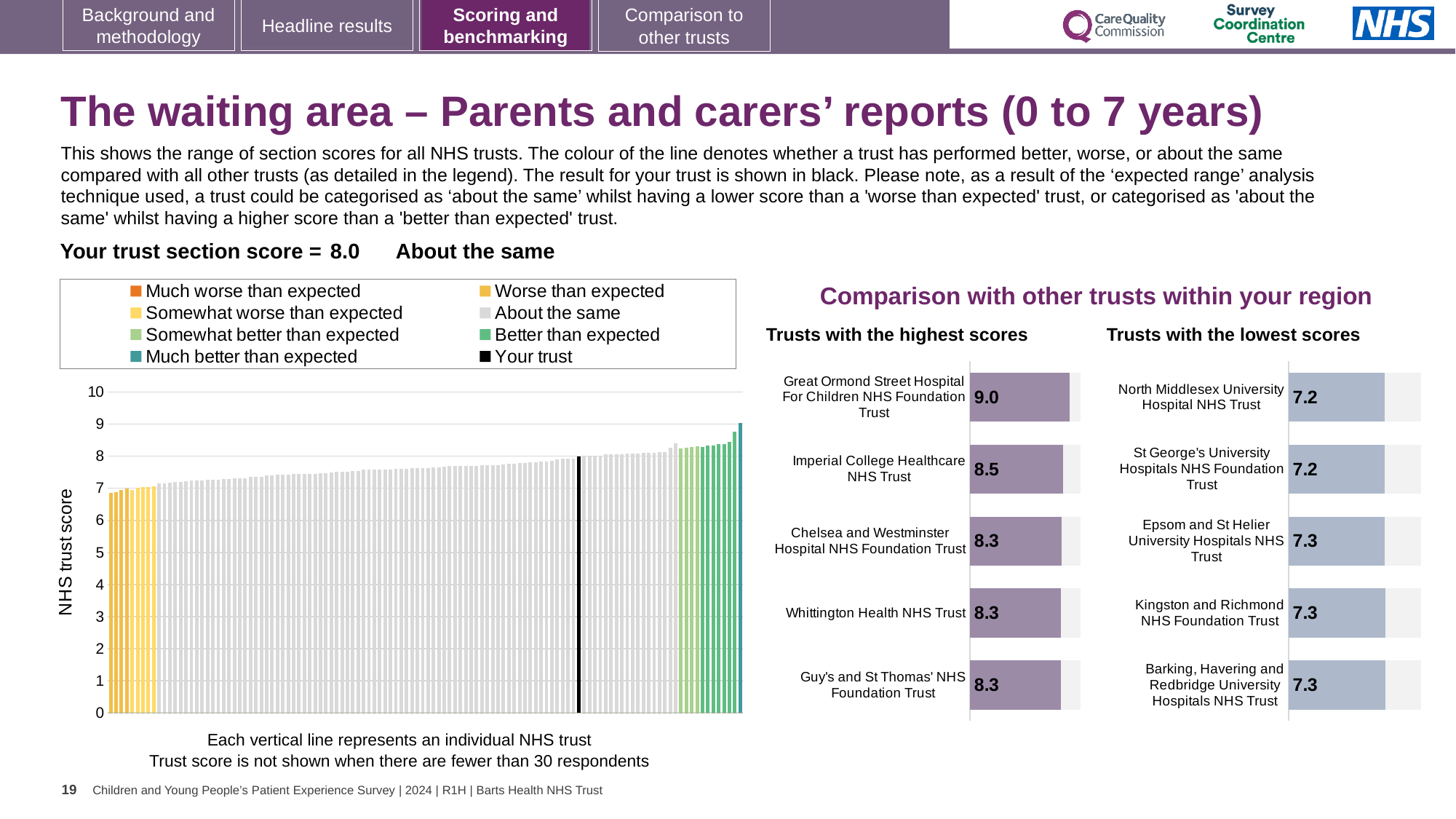
In the main 'NHS trust score' chart on the left, is the value of the tallest bar greater or less than 8? greater In the 'Trusts with the lowest scores' chart, what is the score for North Middlesex University Hospital NHS Trust? 7.2 In the 'Trusts with the highest scores' chart, what is the score for Imperial College Healthcare NHS Trust? 8.5 In the 'Trusts with the lowest scores' chart, what is the score for Epsom and St Helier University Hospitals NHS Trust? 7.3 What kind of chart is the main 'NHS trust score' chart on the left? Bar chart In the 'Trusts with the highest scores' chart, which trust has the highest score? Great Ormond Street Hospital For Children NHS Foundation Trust Which has the larger score: Imperial College Healthcare NHS Trust in the highest-scores chart or Kingston and Richmond NHS Foundation Trust in the lowest-scores chart? Imperial College Healthcare NHS Trust In the main 'NHS trust score' chart on the left, do the bar values rise or fall from left to right? Rise In the main 'NHS trust score' chart on the left, how many entries does the legend list? 8 How many trusts are listed in the 'Trusts with the lowest scores' chart? 5 In the 'Trusts with the highest scores' chart, what is the score for Great Ormond Street Hospital For Children NHS Foundation Trust? 9.0 In the 'Trusts with the highest scores' chart, what is the difference between the scores of Great Ormond Street Hospital For Children NHS Foundation Trust and Imperial College Healthcare NHS Trust? 0.5